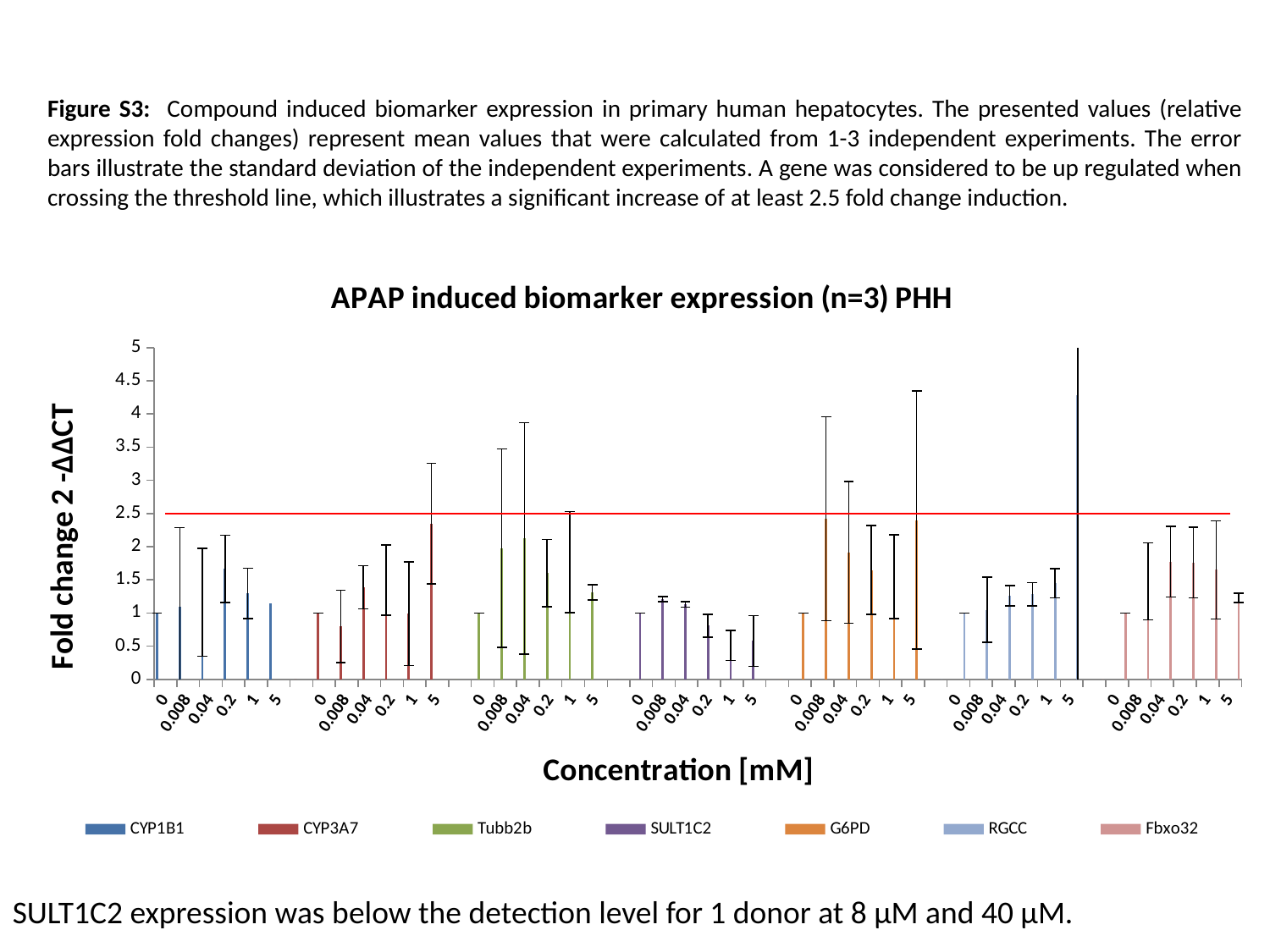
For RGCC, at which concentration is the bar highest? 5 What kind of chart is shown on the slide? bar chart Is the value for Tubb2b at concentration 0.008 greater or less than 1.5? greater Is the value for RGCC at concentration 5 greater or less than 4? greater What is the label of the x axis? Concentration [mM] How many concentration levels are plotted for each gene? 6 What is the title of the chart? APAP induced biomarker expression (n=3) PHH Is the value for SULT1C2 at concentration 0.2 greater or less than 1? less How many series does the legend list? 7 Which gene has the tallest bar in the chart? RGCC